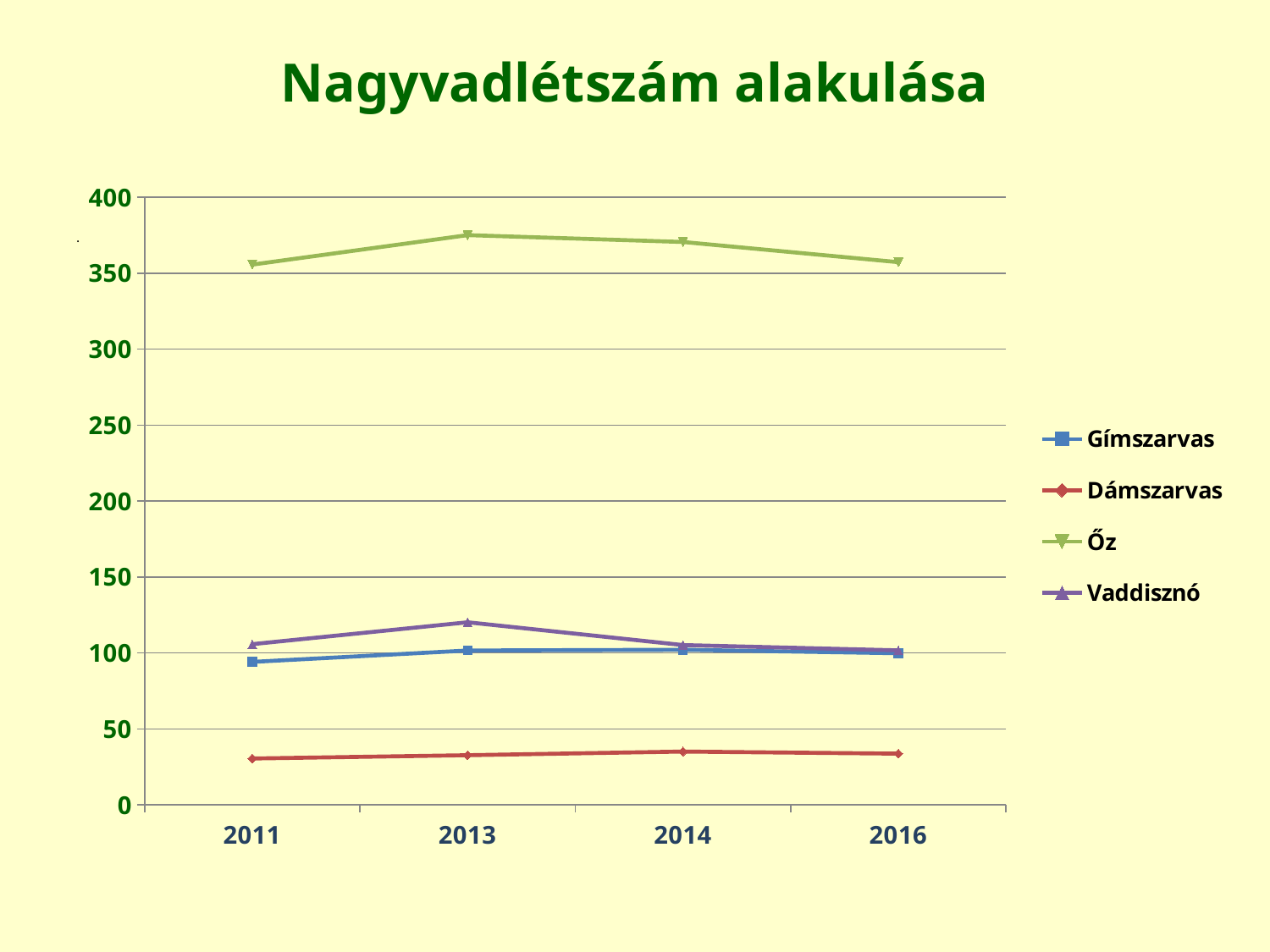
Which series has the highest value in 2013? Őz Is the value for Dámszarvas in 2014 greater or less than 50? less In which year does Vaddisznó reach its highest value? 2013 How many series does the legend list? 4 Which series has the lowest value in 2016? Dámszarvas Is the value for Őz in 2013 greater or less than 350? greater How many years are shown on the x axis? 4 In 2013, which is larger: Vaddisznó or Gímszarvas? Vaddisznó Is the value for Vaddisznó in 2013 greater or less than 100? greater What kind of chart is shown on the slide? line chart What is the title of the chart? Nagyvadlétszám alakulása Does the Dámszarvas line rise or fall from 2011 to 2014? rise